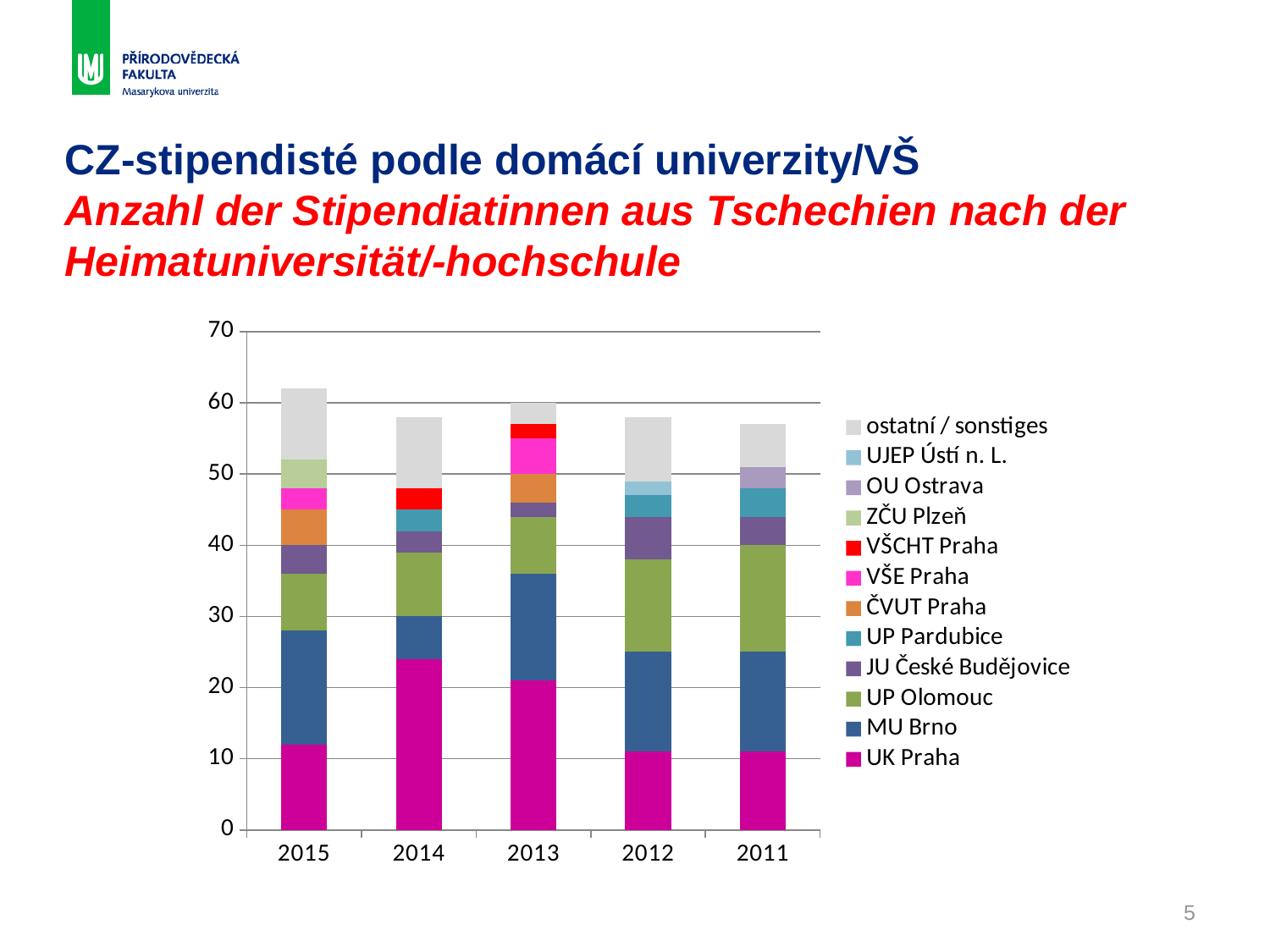
Which year has the larger UK Praha segment, 2014 or 2015? 2014 Is the UK Praha value for 2012 greater or less than 20? less Which series is listed at the top of the chart's legend? ostatní / sonstiges How many series does the chart's legend list? 12 In which year is the UK Praha segment the largest? 2014 Is the UK Praha value for 2014 greater or less than 20? greater Is the total height of the 2011 bar greater or less than 60? less How many years are shown on the x axis of the chart? 5 Which year has the tallest stacked bar overall? 2015 Which series is listed at the bottom of the chart's legend? UK Praha What kind of chart is shown on the slide? stacked bar chart